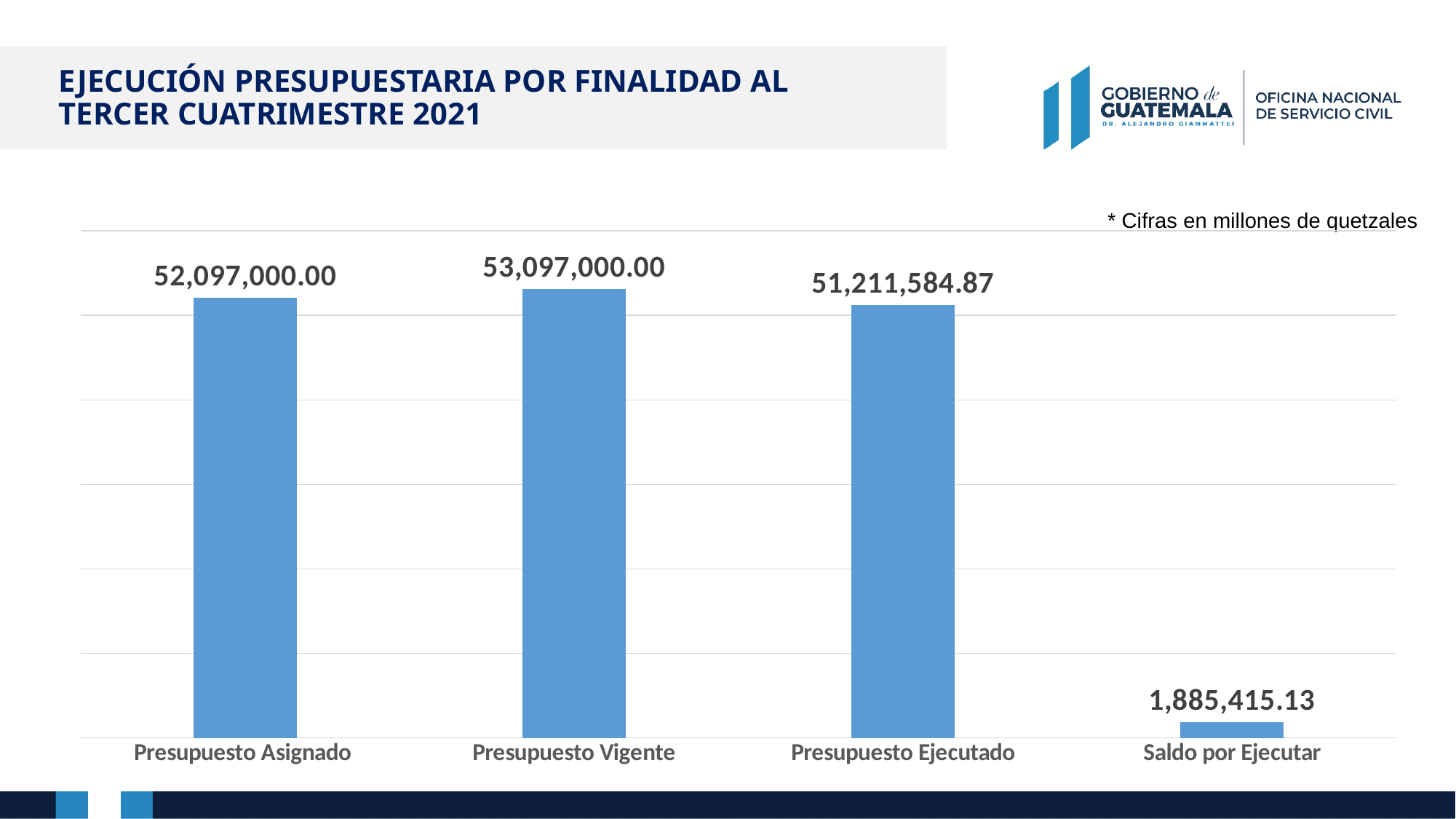
What is the difference between Presupuesto Vigente and Presupuesto Ejecutado? 1,885,415.13 How many categories are shown in the chart? 4 What kind of chart is shown on the slide? Bar chart According to the note on the chart, in what units are the figures expressed? Millones de quetzales Which category has the highest value? Presupuesto Vigente What is the value for Saldo por Ejecutar? 1,885,415.13 Which category has the lowest value? Saldo por Ejecutar What is the value for Presupuesto Asignado? 52,097,000.00 What is the value for Presupuesto Ejecutado? 51,211,584.87 Which is larger, Presupuesto Asignado or Presupuesto Ejecutado? Presupuesto Asignado What is the difference between Presupuesto Vigente and Presupuesto Asignado? 1,000,000.00 What is the value for Presupuesto Vigente? 53,097,000.00